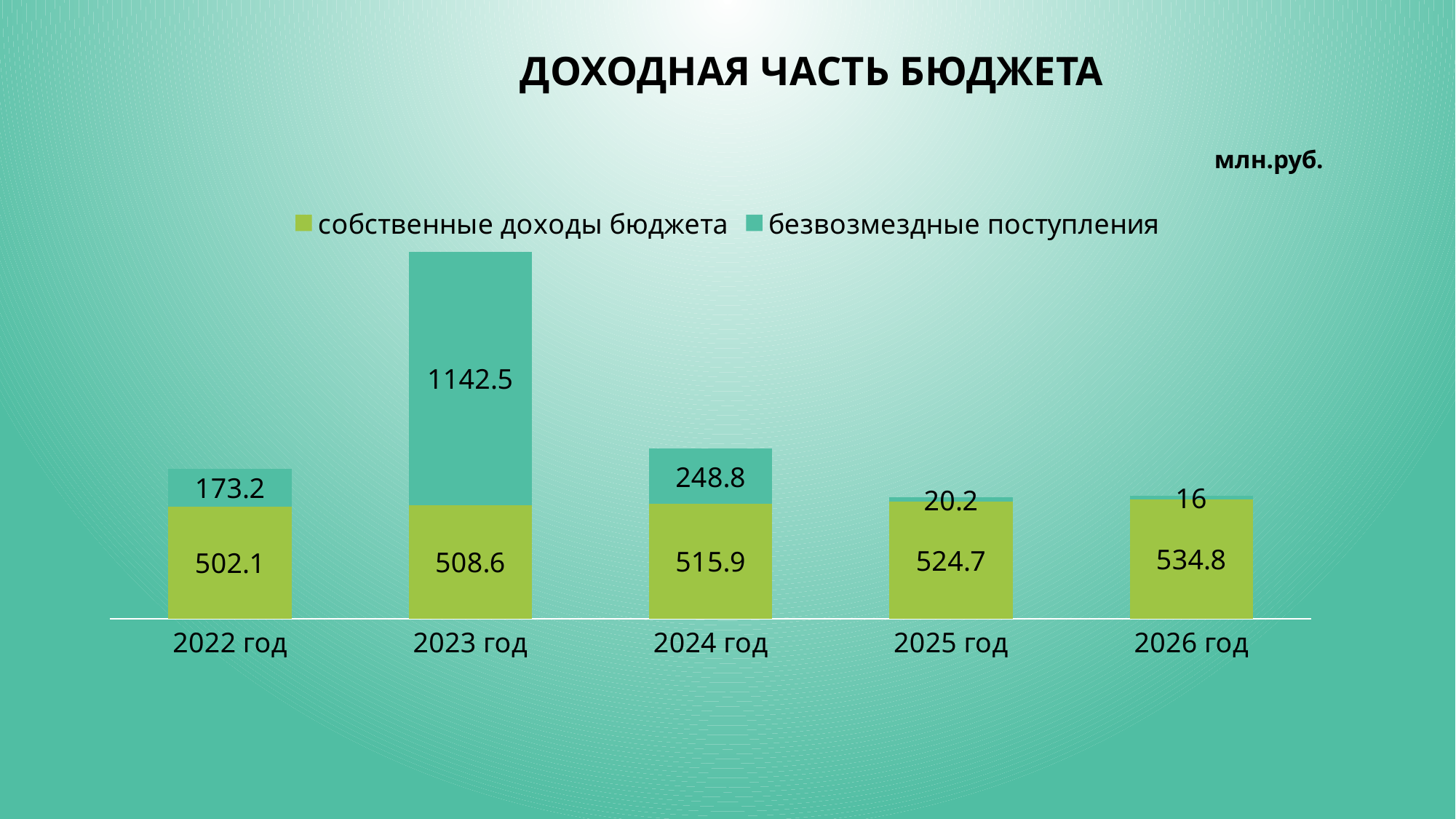
What is the difference between собственные доходы бюджета in 2026 год and 2022 год? 32.7 In which year is собственные доходы бюджета lowest? 2022 год What kind of chart is shown on the slide? Stacked bar chart What is the value of безвозмездные поступления for 2024 год? 248.8 What is the value of собственные доходы бюджета for 2023 год? 508.6 What is the total of the stacked bar for 2023 год? 1651.1 What is the value of безвозмездные поступления for 2026 год? 16 How many years are shown on the x axis? 5 What is the total of the stacked bar for 2025 год? 544.9 Which is larger: безвозмездные поступления in 2022 год or in 2024 год? 2024 год In which year is безвозмездные поступления highest? 2023 год How many series does the legend list? 2